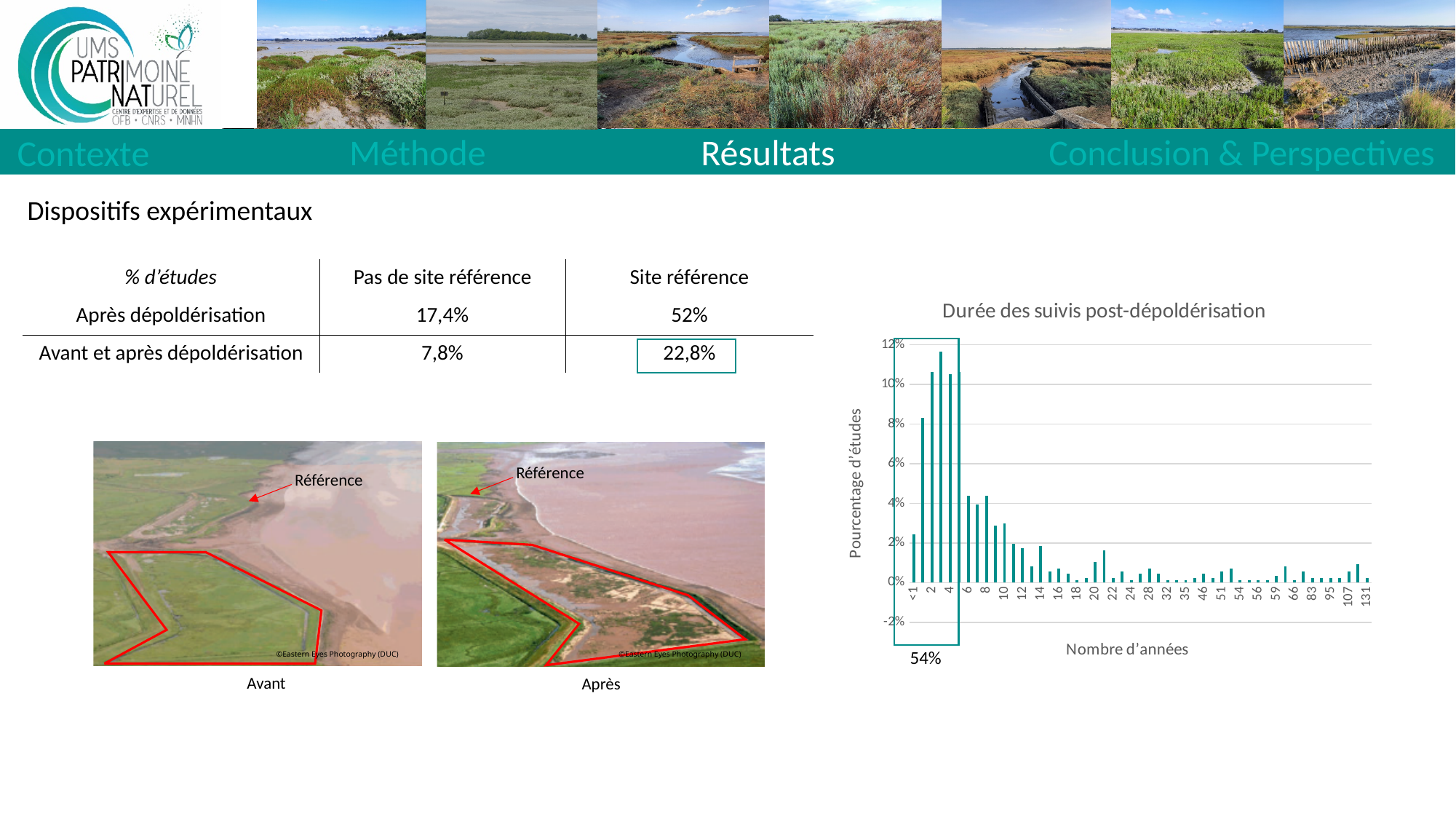
In the chart 'Durée des suivis post-dépoldérisation', is the value for 4 years greater or less than 8%? greater In the chart 'Durée des suivis post-dépoldérisation', which has the larger value: 2 years or 6 years? 2 years In the chart 'Durée des suivis post-dépoldérisation', is the value for <1 year greater or less than 4%? less What kind of chart is shown under the title 'Durée des suivis post-dépoldérisation'? bar chart In the chart 'Durée des suivis post-dépoldérisation', is the value for 6 years greater or less than 6%? less In the chart 'Durée des suivis post-dépoldérisation', what percentage is annotated below the highlighted box around the first bars? 54% In the chart 'Durée des suivis post-dépoldérisation', which has the larger value: 6 years or 12 years? 6 years In the chart 'Durée des suivis post-dépoldérisation', which has the larger value: <1 year or 2 years? 2 years What is the title of the chart on the right of the slide? Durée des suivis post-dépoldérisation In the chart 'Durée des suivis post-dépoldérisation', do the values generally rise or fall along the x axis from 4 years onward? fall